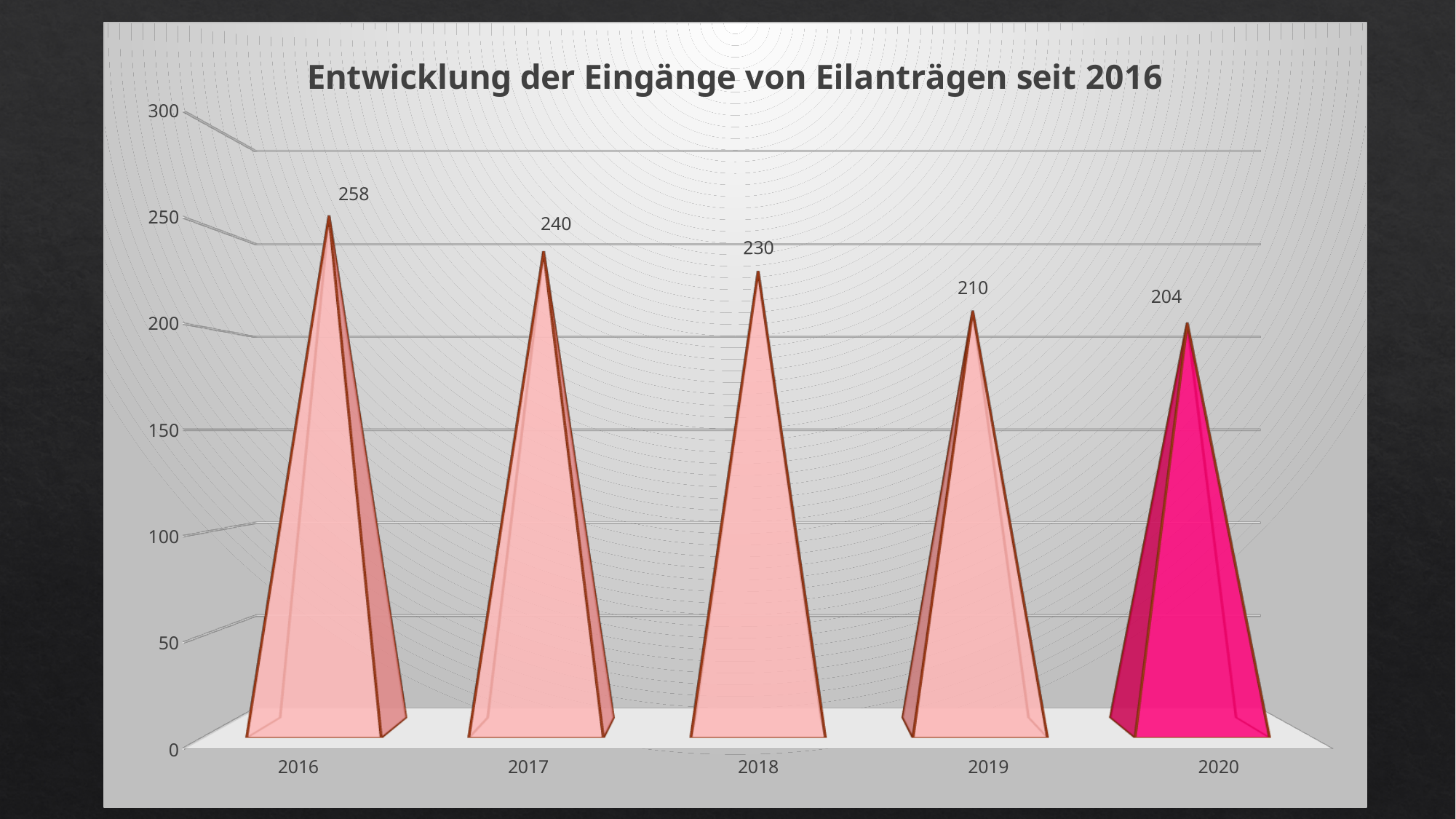
What is the value for 2020? 204 Which is larger, the value for 2017 or the value for 2019? 2017 Is the value for 2019 greater or less than 200? greater What is the difference between the values for 2017 and 2018? 10 Which year has the lowest value? 2020 What kind of chart is this? bar chart How many years are shown on the x axis? 5 Which year has the highest value? 2016 What is the difference between the values for 2016 and 2020? 54 What is the value for 2016? 258 Do the values rise or fall from 2016 to 2020? fall What is the value for 2018? 230